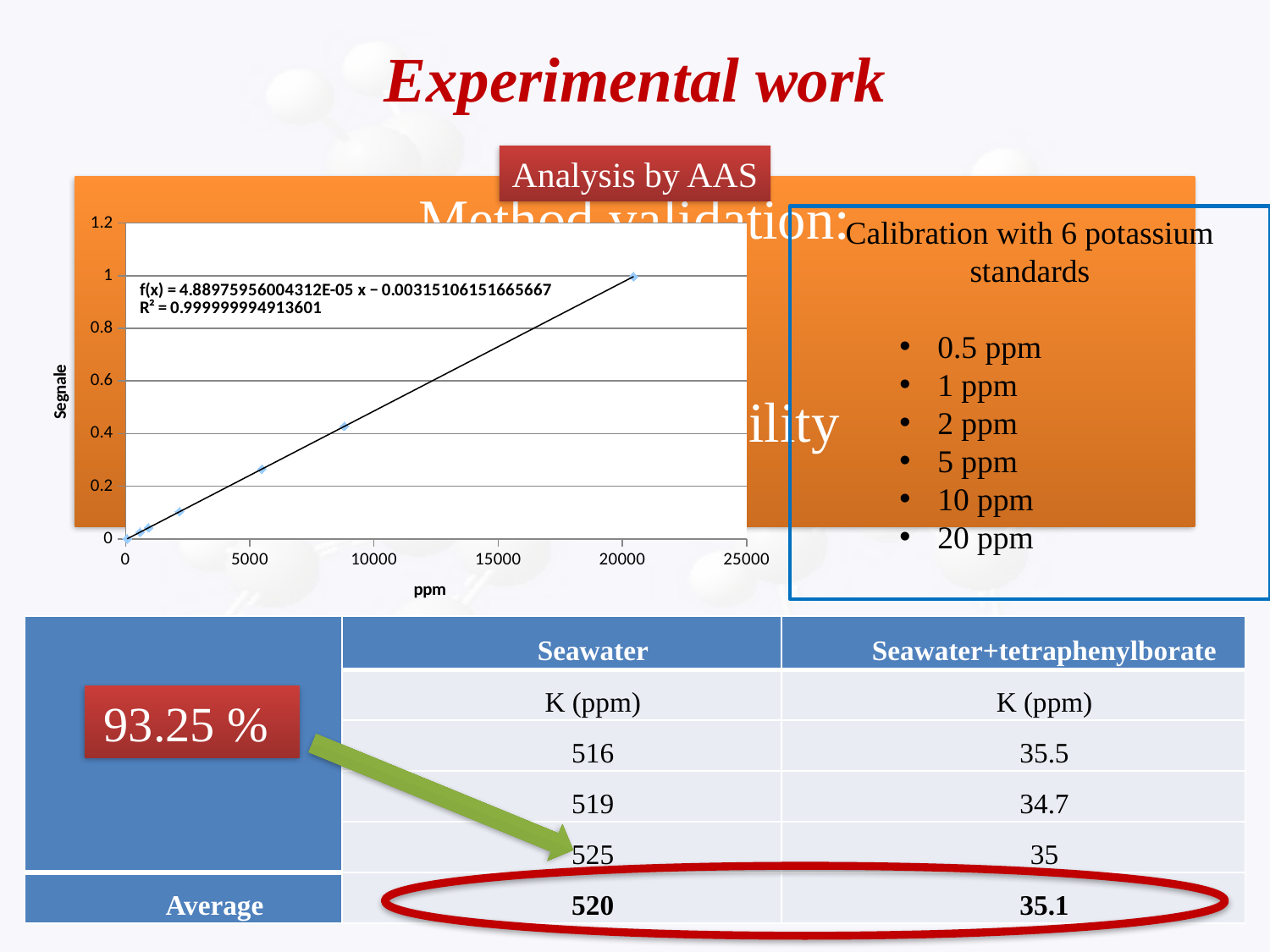
What kind of chart is shown on the slide? scatter chart Is the signal value for the point near 5500 ppm greater or less than 0.4? less Is the signal value for the point near 2000 ppm greater or less than 0.2? less Is the signal value for the point near 9000 ppm greater or less than 0.6? less What R² value is printed on the chart? 0.999999994913601 What is the label of the y axis of the chart? Segnale Do the plotted signal values rise or fall as ppm increases along the x axis? rise